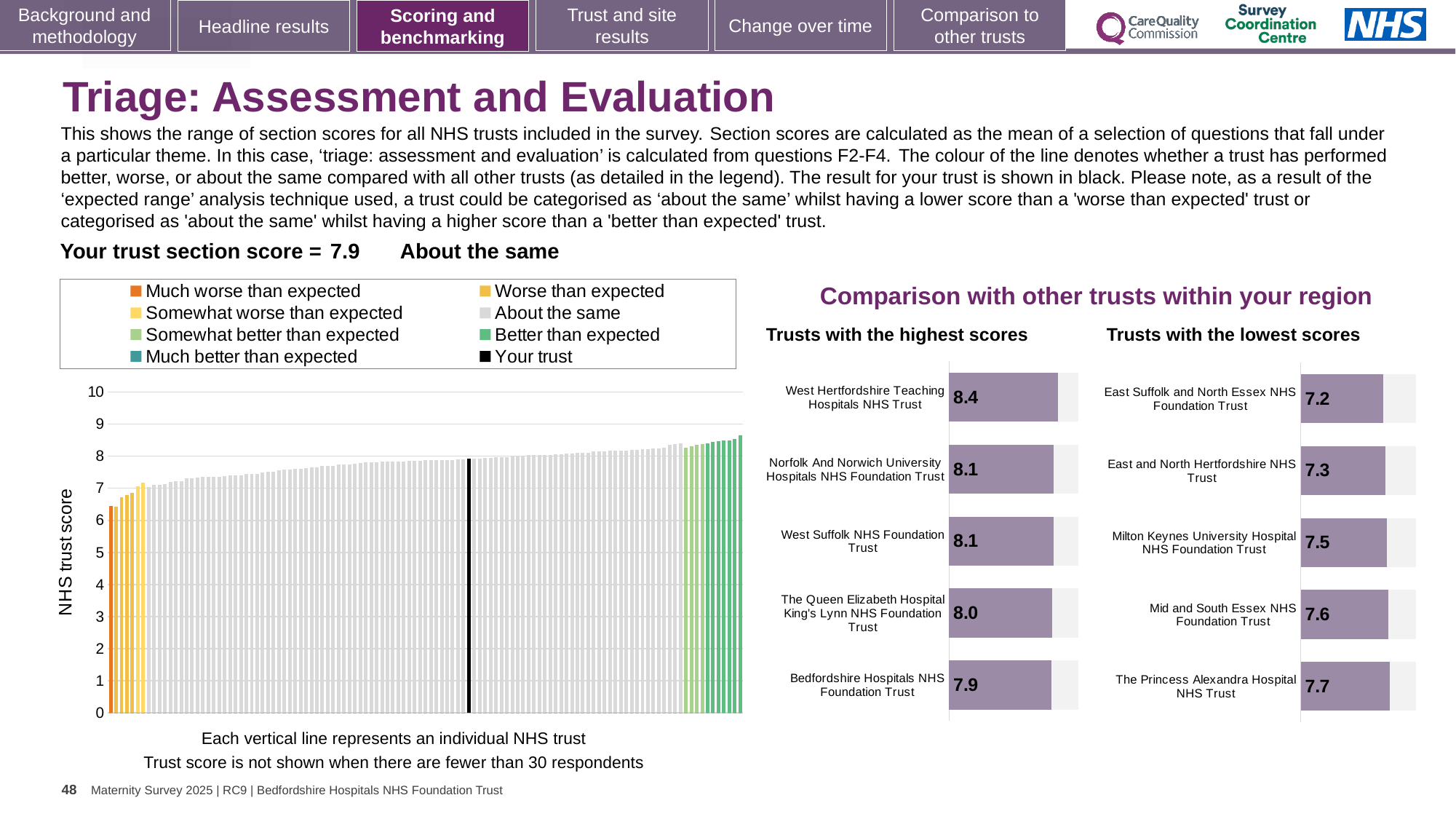
In the 'Trusts with the highest scores' chart, what is the difference between the scores of West Hertfordshire Teaching Hospitals NHS Trust and Bedfordshire Hospitals NHS Foundation Trust? 0.5 In the large chart on the left, do the trust scores rise or fall from left to right? Rise What kind of chart is the large chart on the left showing all NHS trusts? Bar chart How many trusts are listed in the 'Trusts with the lowest scores' chart? 5 In the 'Trusts with the highest scores' chart, what is the score for West Hertfordshire Teaching Hospitals NHS Trust? 8.4 In the 'Trusts with the lowest scores' chart, which trust has the lowest score? East Suffolk and North Essex NHS Foundation Trust In the 'Trusts with the lowest scores' chart, which has the larger score: Mid and South Essex NHS Foundation Trust or East and North Hertfordshire NHS Trust? Mid and South Essex NHS Foundation Trust In the large chart on the left, is the value of the lowest (leftmost) bar greater or less than 7? less In the 'Trusts with the lowest scores' chart, what is the score for Milton Keynes University Hospital NHS Foundation Trust? 7.5 In the 'Trusts with the highest scores' chart, which trust has the highest score? West Hertfordshire Teaching Hospitals NHS Trust How many entries does the legend of the large chart on the left list? 8 In the 'Trusts with the highest scores' chart, what is the score for The Queen Elizabeth Hospital King's Lynn NHS Foundation Trust? 8.0